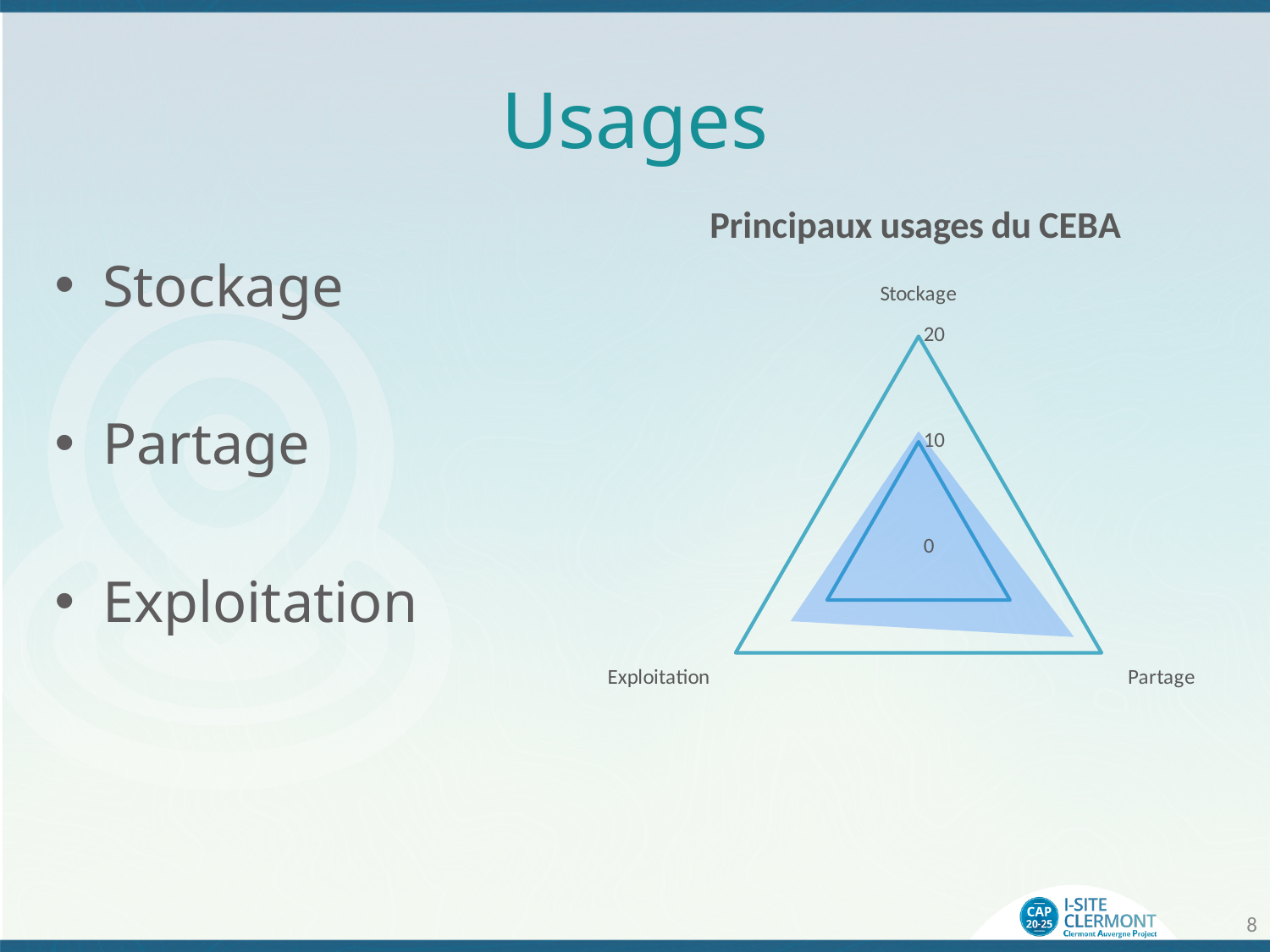
Which is larger, the value for Partage or the value for Stockage? Partage How many categories (axes) does the radar chart have? 3 What is the title of the chart? Principaux usages du CEBA What kind of chart is shown on the slide? Radar chart Which is larger, the value for Partage or the value for Exploitation? Partage Is the value for Stockage greater or less than 20? less Is the value for Exploitation greater or less than 10? greater What is the maximum value shown on the chart's axis scale? 20 Is the value for Partage greater or less than 10? greater Which category has the highest value in the chart? Partage